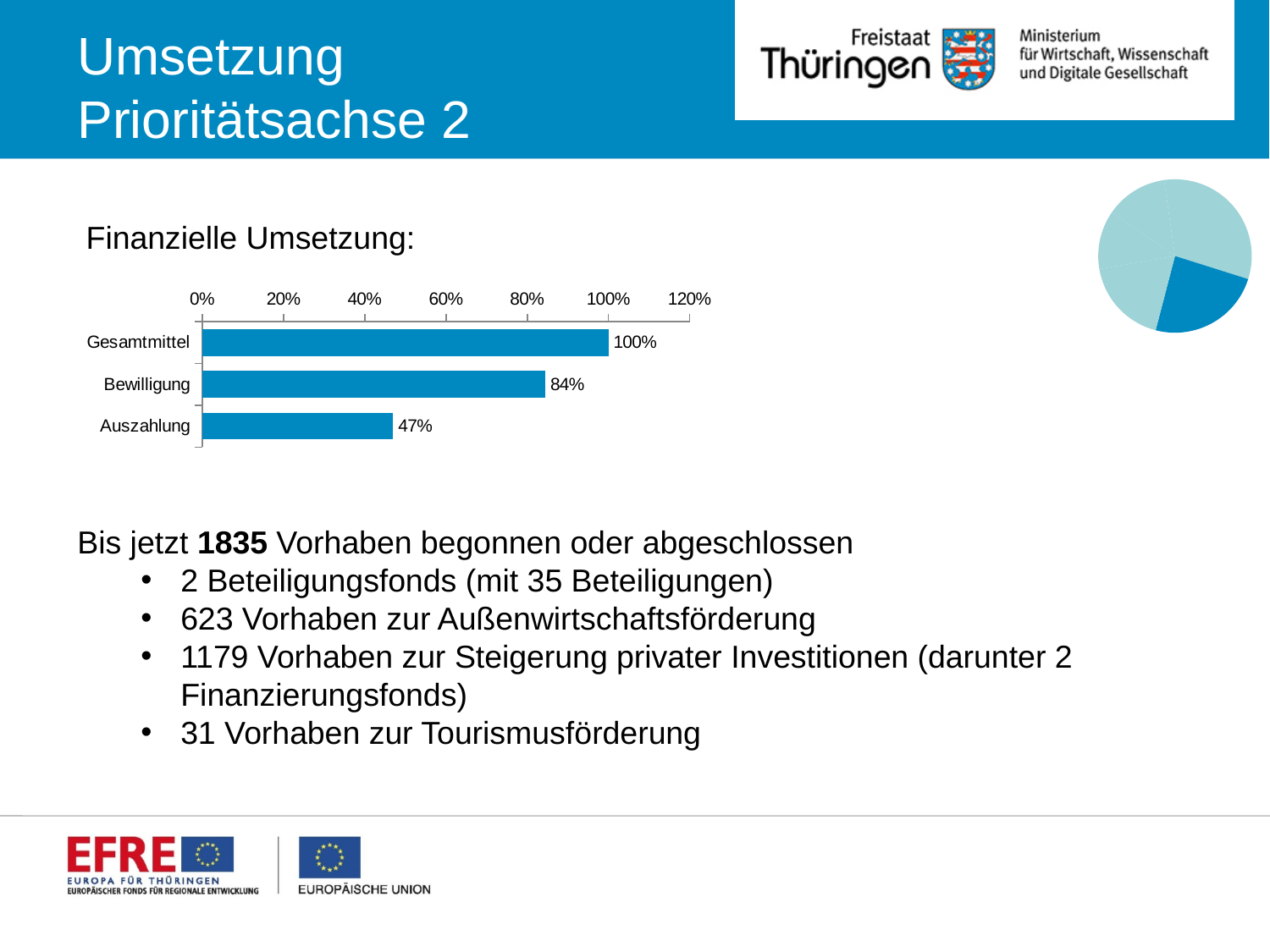
In the bar chart under "Finanzielle Umsetzung", is the value for Auszahlung greater or less than 60%? less What kind of chart is shown under "Finanzielle Umsetzung"? bar chart In the bar chart under "Finanzielle Umsetzung", which is larger: the value for Bewilligung or the value for Auszahlung? Bewilligung In the bar chart under "Finanzielle Umsetzung", what is the value for Gesamtmittel? 100% In the bar chart under "Finanzielle Umsetzung", what is the value for Bewilligung? 84% In the bar chart under "Finanzielle Umsetzung", what is the difference between the values for Gesamtmittel and Bewilligung? 16% In the bar chart under "Finanzielle Umsetzung", what is the value for Auszahlung? 47% In the bar chart under "Finanzielle Umsetzung", what is the difference between the values for Bewilligung and Auszahlung? 37% In the bar chart under "Finanzielle Umsetzung", which category has the highest value? Gesamtmittel How many categories are shown in the bar chart under "Finanzielle Umsetzung"? 3 In the bar chart under "Finanzielle Umsetzung", which category has the lowest value? Auszahlung What is the highest tick value shown on the axis of the bar chart under "Finanzielle Umsetzung"? 120%